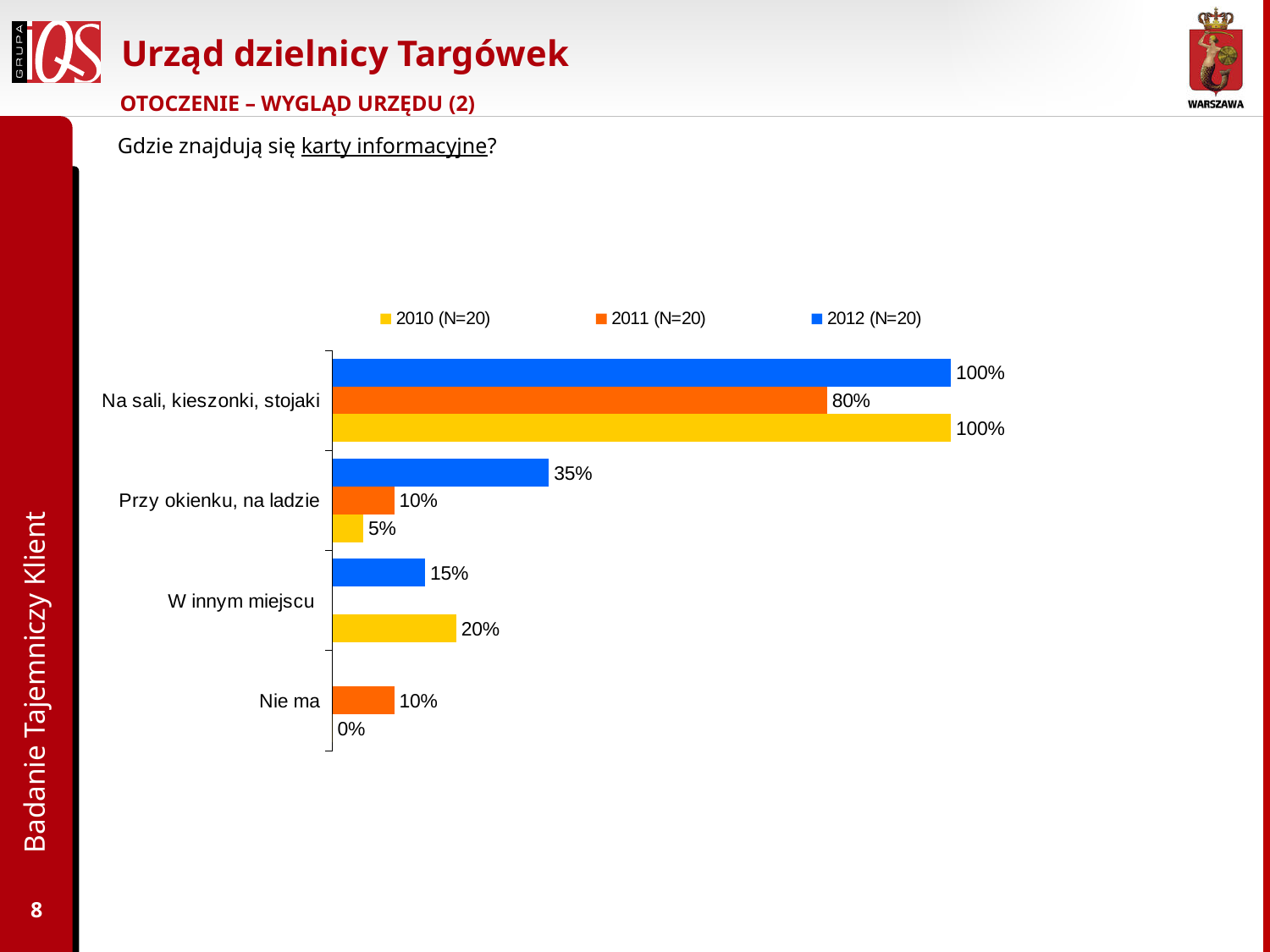
What is the value for 2010 (N=20) in the category "W innym miejscu"? 20% What is the value for 2012 (N=20) in the category "Na sali, kieszonki, stojaki"? 100% How many categories are shown on the chart? 4 What is the difference between the 2012 (N=20) and 2011 (N=20) values for "Przy okienku, na ladzie"? 25% Which is larger for "W innym miejscu": the 2010 (N=20) value or the 2012 (N=20) value? 2010 (N=20) Which category has the highest value for 2012 (N=20)? Na sali, kieszonki, stojaki What kind of chart is shown on the slide? bar chart What is the value for 2010 (N=20) in the category "Przy okienku, na ladzie"? 5% What is the value for 2011 (N=20) in the category "Na sali, kieszonki, stojaki"? 80% What is the value for 2011 (N=20) in the category "Nie ma"? 10% How many series does the legend list? 3 What is the value for 2012 (N=20) in the category "Przy okienku, na ladzie"? 35%